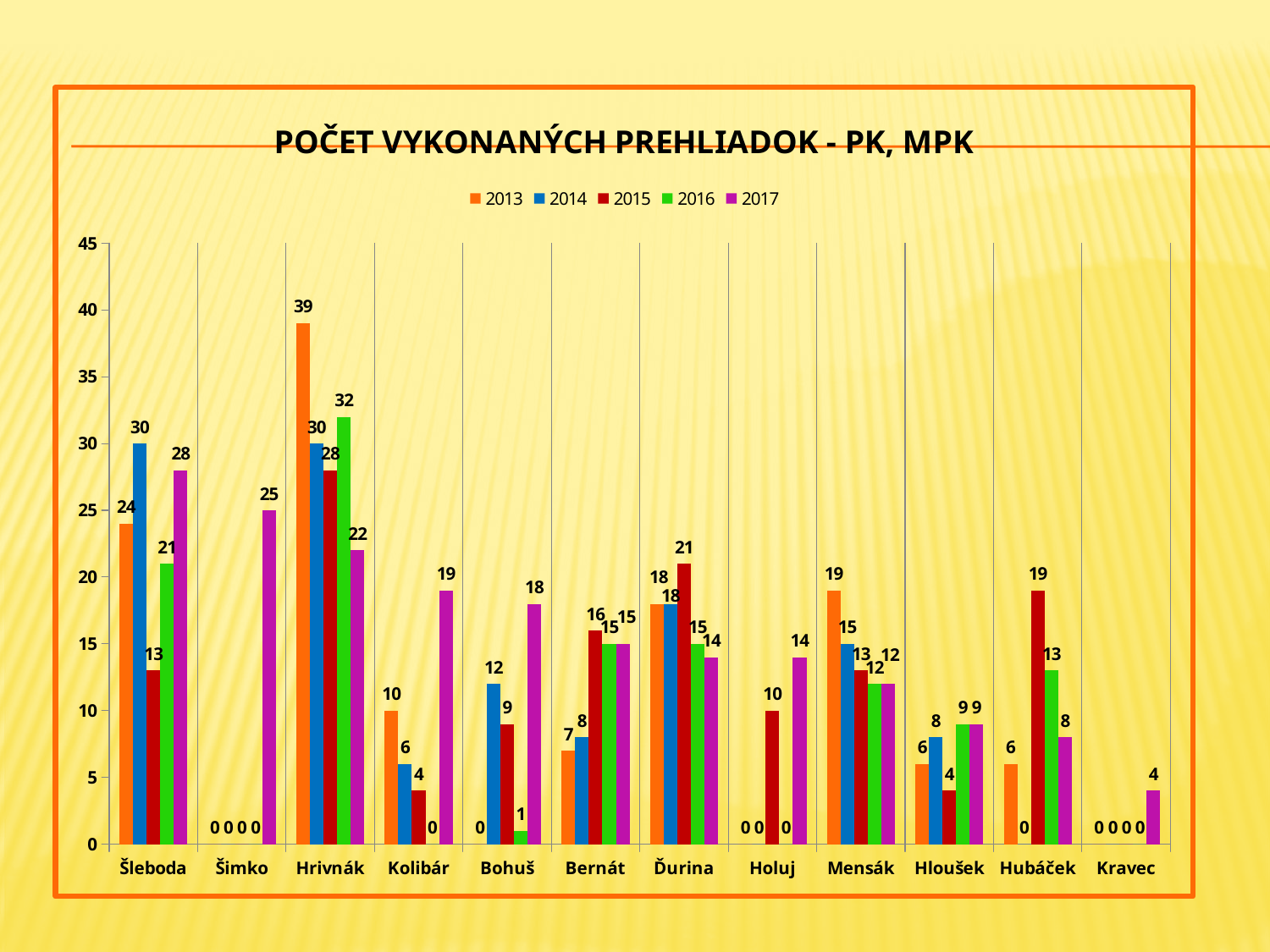
Which category has the lowest value in the 2017 series? Kravec What is the value for Hubáček in 2015? 19 What is the title of the chart? POČET VYKONANÝCH PREHLIADOK - PK, MPK How many series does the legend list? 5 What is the value for Hrivnák in 2013? 39 What is the difference between the 2014 and 2015 values for Šleboda? 17 What is the value for Šimko in 2017? 25 How many categories are shown on the x axis? 12 What kind of chart is shown on the slide? bar chart Which is larger for Mensák: the 2013 value or the 2014 value? 2013 Which category has the highest value in the 2013 series? Hrivnák What is the total of the five values for Hloušek? 36